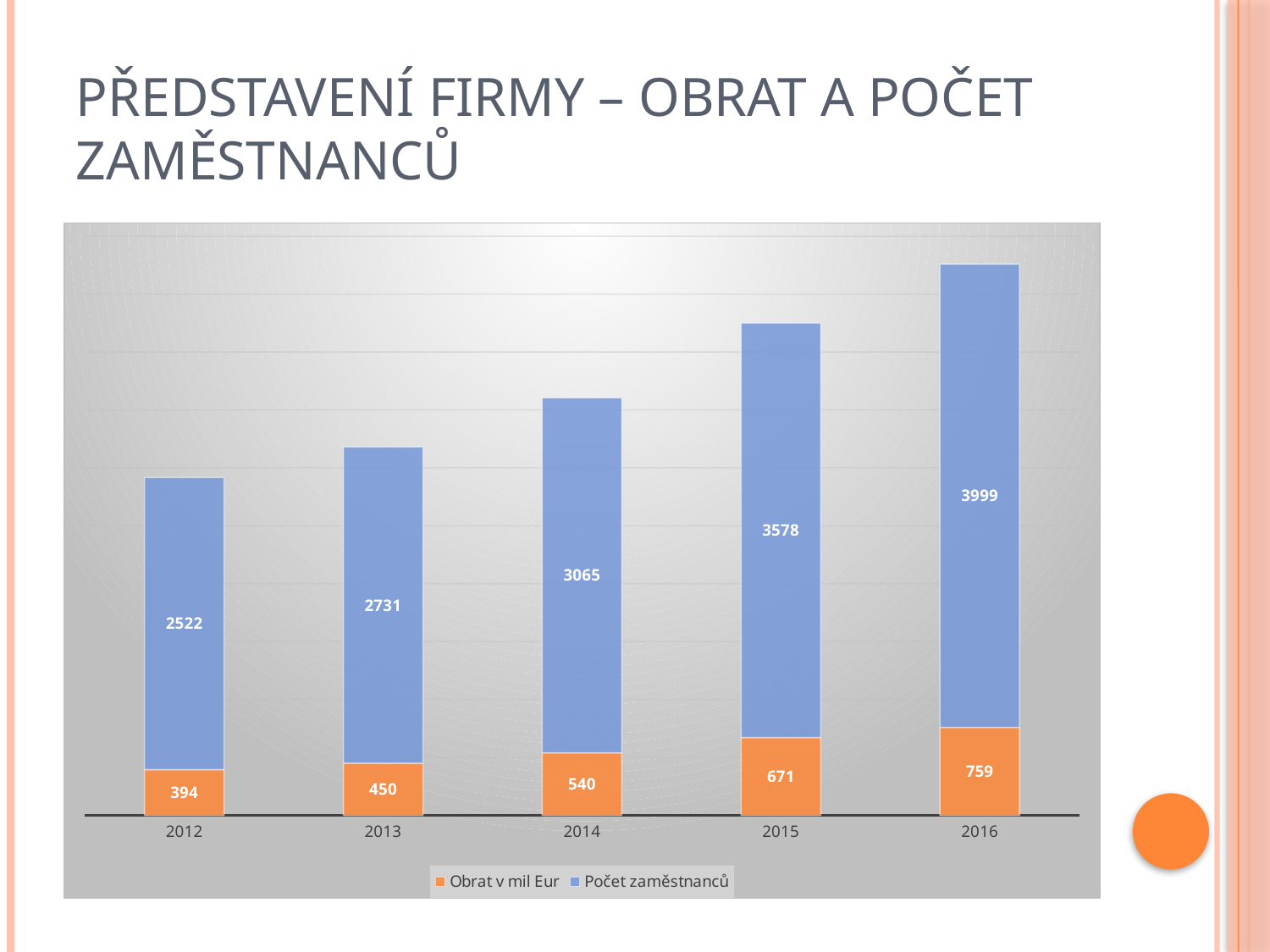
Which series is shown in orange? Obrat v mil Eur What is the value of Počet zaměstnanců for 2013? 2731 Which is larger, Obrat v mil Eur in 2015 or in 2013? 2015 What is the total of the stacked bar for 2015? 4249 Which year has the lowest Obrat v mil Eur? 2012 What is the value of Obrat v mil Eur for 2014? 540 What is the difference in Počet zaměstnanců between 2016 and 2012? 1477 Do the Počet zaměstnanců values rise or fall from 2012 to 2016? Rise How many years are shown on the x axis? 5 How many series does the legend list? 2 Which year has the highest Počet zaměstnanců? 2016 What kind of chart is shown on the slide? Stacked bar chart